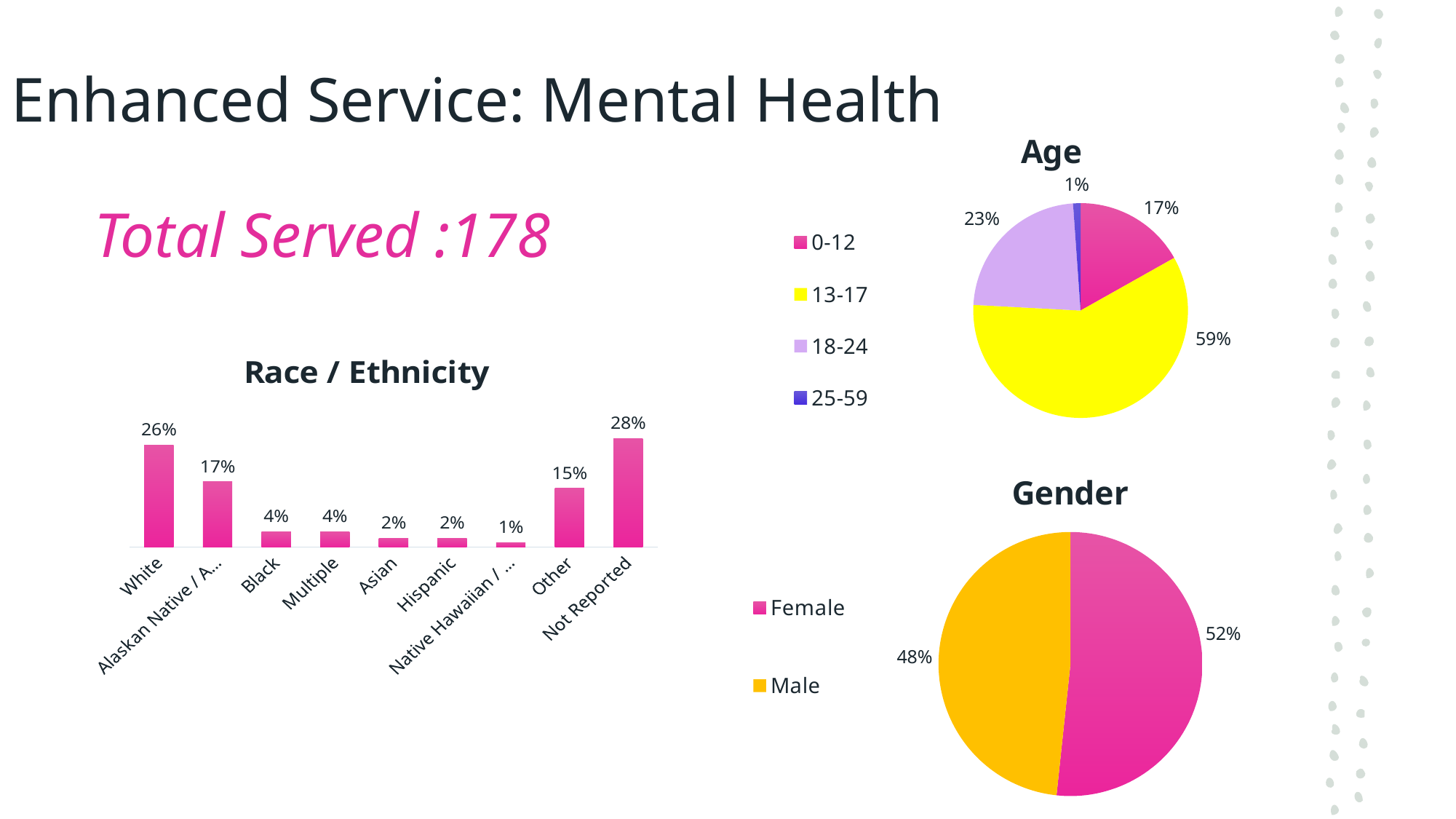
In the Gender chart, which is larger, Female or Male? Female In the Race / Ethnicity chart, which is larger, the value for Black or the value for Other? Other How many entries does the legend of the Age chart list? 4 In the Gender chart, what share of the pie is Male? 48% In the Race / Ethnicity chart, which category has the highest value? Not Reported What kind of chart is the Race / Ethnicity chart? Bar chart How many categories are shown in the Race / Ethnicity chart? 9 In the Race / Ethnicity chart, what is the value for White? 26% In the Race / Ethnicity chart, what is the difference between the values for Not Reported and White? 2% In the Age chart, what share of the pie is the 13-17 slice? 59% What kind of chart is the Gender chart? Pie chart In the Age chart, which age group has the smallest slice? 25-59